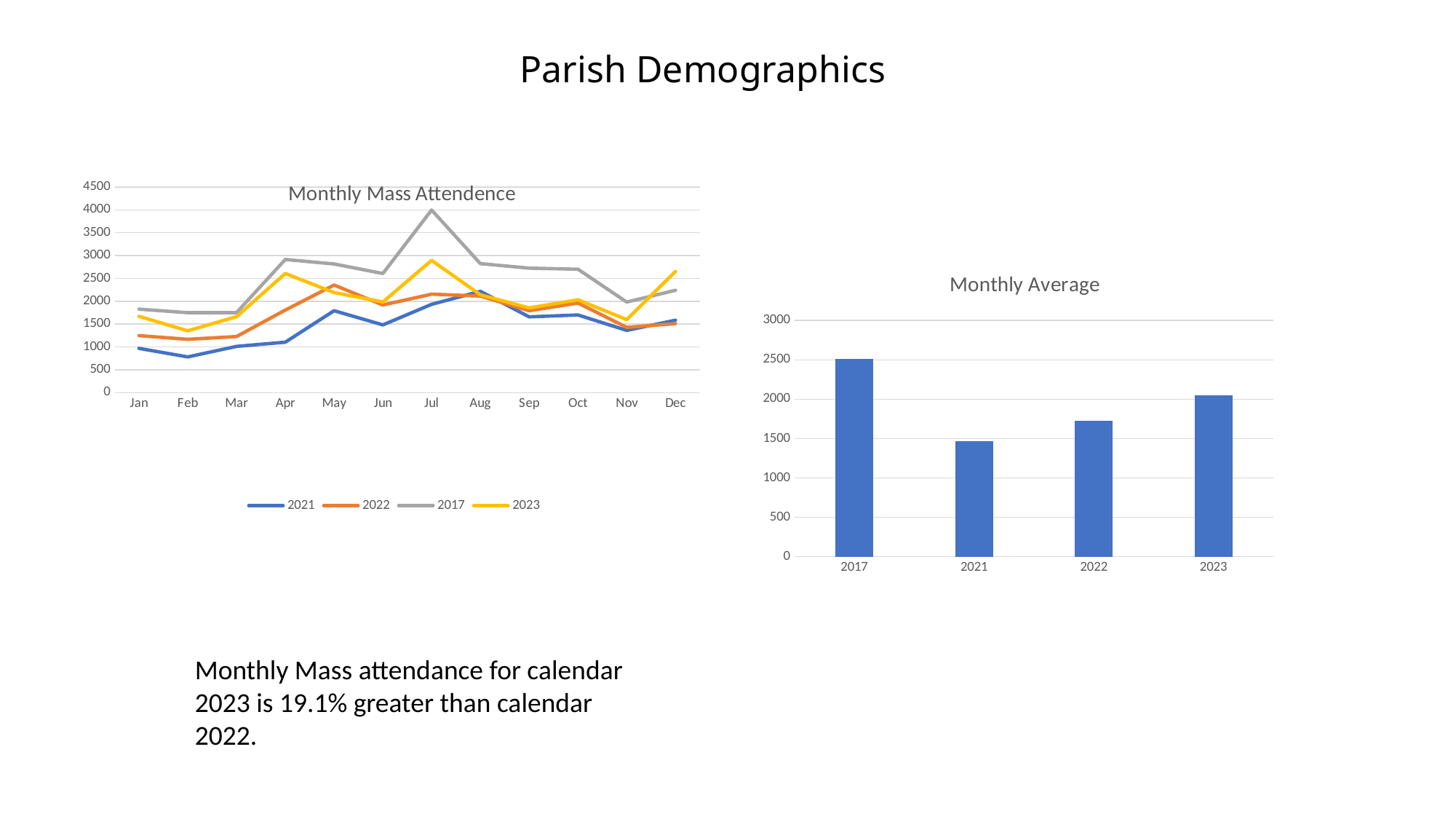
How many bars are in the "Monthly Average" chart? 4 How many series does the legend of the "Monthly Mass Attendence" chart list? 4 In the "Monthly Average" chart, which is larger, the value for 2022 or the value for 2023? 2023 What kind of chart is the "Monthly Average" chart? bar chart In the "Monthly Average" chart, is the value for 2017 greater or less than 2000? greater How many months are shown on the x axis of the "Monthly Mass Attendence" chart? 12 In the "Monthly Mass Attendence" chart, which series reaches the highest value in Jul? 2017 What kind of chart is the "Monthly Mass Attendence" chart? line chart In the "Monthly Mass Attendence" chart, is the 2017 value for Jul greater or less than 3500? greater In the "Monthly Average" chart, which year has the highest bar? 2017 In the "Monthly Average" chart, which year has the lowest bar? 2021